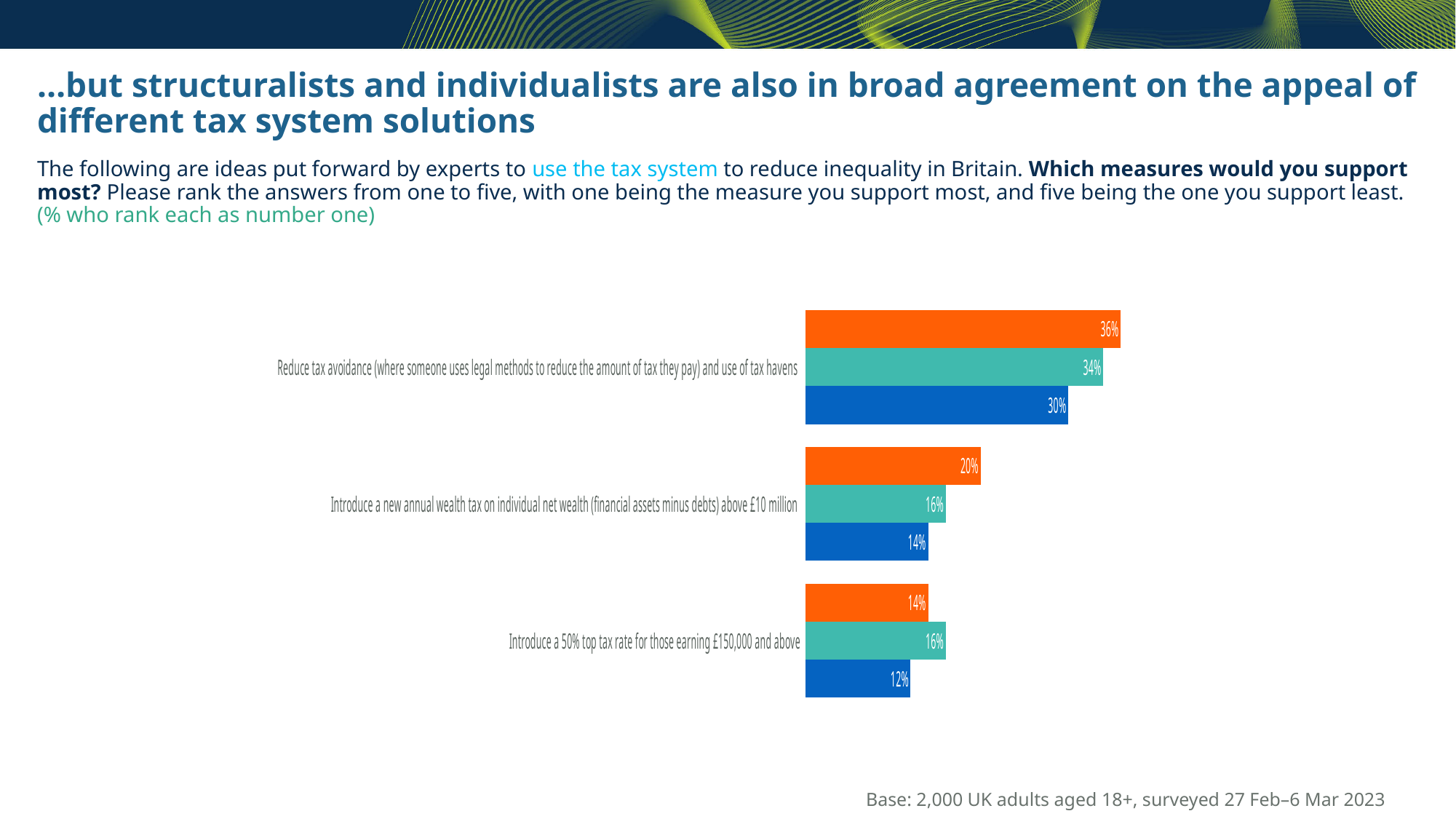
How many bars are shown for each tax measure in the chart? 3 Which tax measure has the highest value across all bars in the chart? Reduce tax avoidance (where someone uses legal methods to reduce the amount of tax they pay) and use of tax havens Which bar has the lowest value in the chart? The blue bar for 'Introduce a 50% top tax rate for those earning £150,000 and above' (12%) What is the difference between the orange bar for the annual wealth tax measure and the orange bar for the 50% top tax rate measure? 6 percentage points What is the value of the teal bar for 'Introduce a 50% top tax rate for those earning £150,000 and above'? 16% For 'Introduce a 50% top tax rate for those earning £150,000 and above', which is larger: the orange bar or the teal bar? The teal bar What kind of chart is shown on the slide? Bar chart What is the difference between the orange bar and the blue bar for 'Reduce tax avoidance (where someone uses legal methods to reduce the amount of tax they pay) and use of tax havens'? 6 percentage points What colour is the bar showing 34% in the chart? Teal What is the value of the blue bar for 'Introduce a new annual wealth tax on individual net wealth (financial assets minus debts) above £10 million'? 14% What is the value of the orange bar for 'Reduce tax avoidance (where someone uses legal methods to reduce the amount of tax they pay) and use of tax havens'? 36% How many categories (tax measures) are shown in the chart? 3